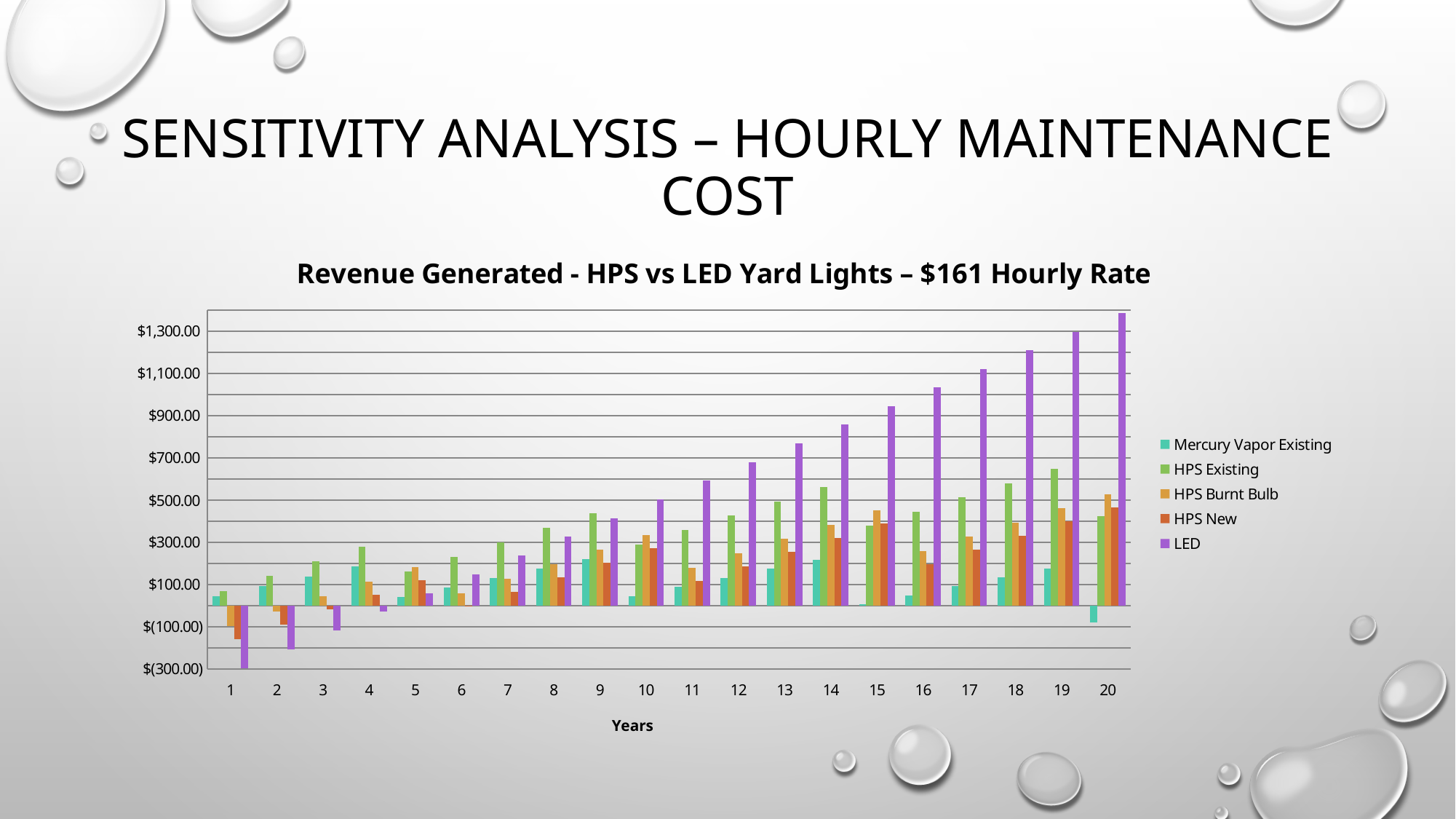
What kind of chart is shown on the slide? bar chart Is the LED value in year 1 greater or less than $(100.00)? less Is the HPS Existing value in year 19 greater or less than $500.00? greater Which series has the lowest value in year 20? Mercury Vapor Existing Do the LED values rise or fall from year 1 to year 20? rise Which series has the lowest value in year 1? LED In year 1, which is larger: HPS Existing or LED? HPS Existing How many years are shown along the x axis? 20 Is the LED value in year 20 greater or less than $1,300.00? greater How many series does the legend list? 5 Which series has the highest value in year 20? LED What is the title of the chart? Revenue Generated - HPS vs LED Yard Lights – $161 Hourly Rate